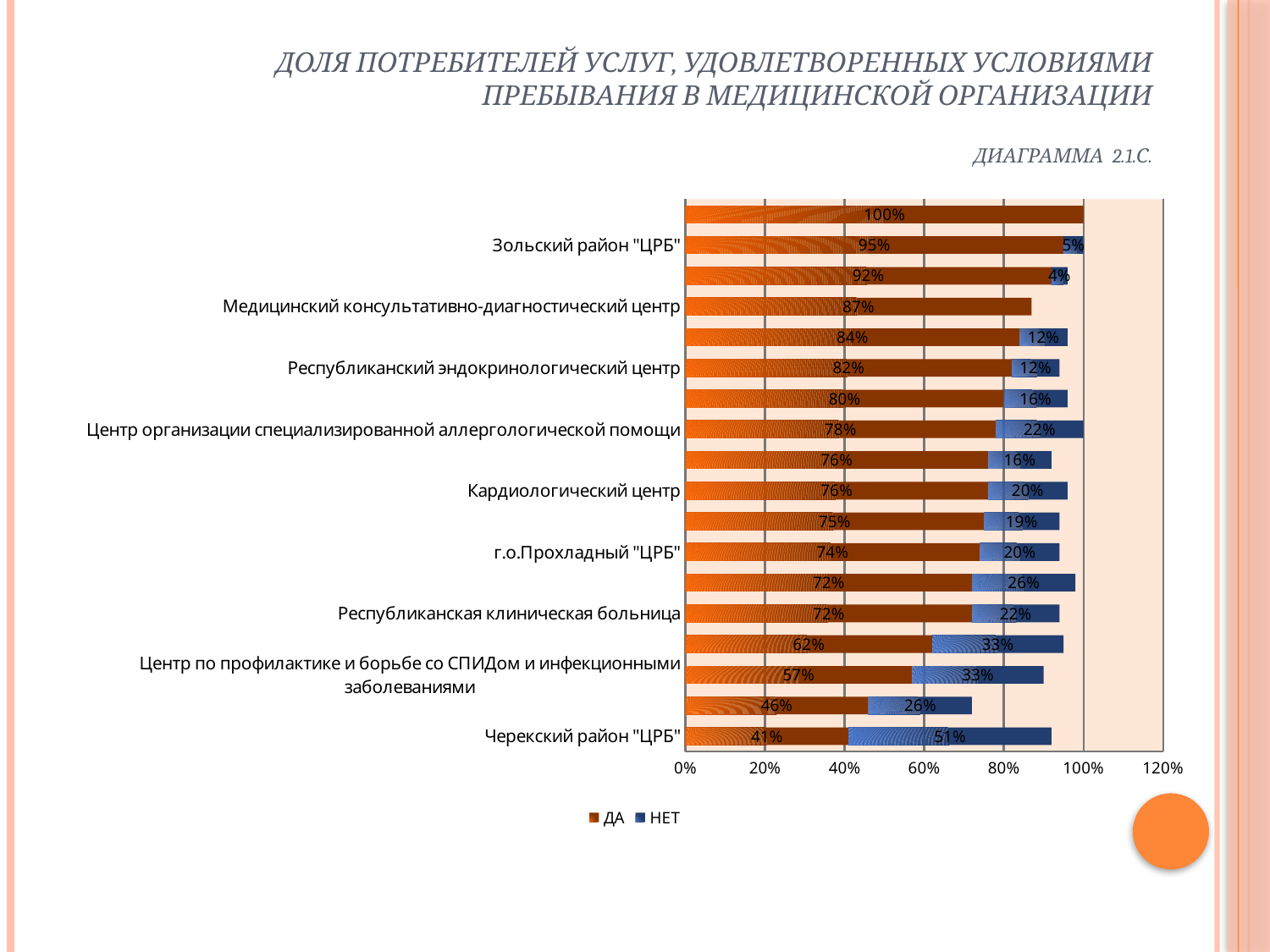
Which has a larger ДА value: Зольский район "ЦРБ" or Черекский район "ЦРБ"? Зольский район "ЦРБ" What are the two legend entries of the chart? ДА and НЕТ How many series does the legend list? 2 What is the НЕТ value for Черекский район "ЦРБ"? 51% What is the ДА value for Кардиологический центр? 76% What is the НЕТ value for Республиканская клиническая больница? 22% What is the difference between the ДА values of Зольский район "ЦРБ" and Черекский район "ЦРБ"? 54% What kind of chart is shown on the slide? bar chart What is the ДА value for г.о.Прохладный "ЦРБ"? 74% What is the НЕТ value for Центр организации специализированной аллергологической помощи? 22% What is the ДА value for Зольский район "ЦРБ"? 95% What is the total of the stacked bar (ДА plus НЕТ) for Черекский район "ЦРБ"? 92%